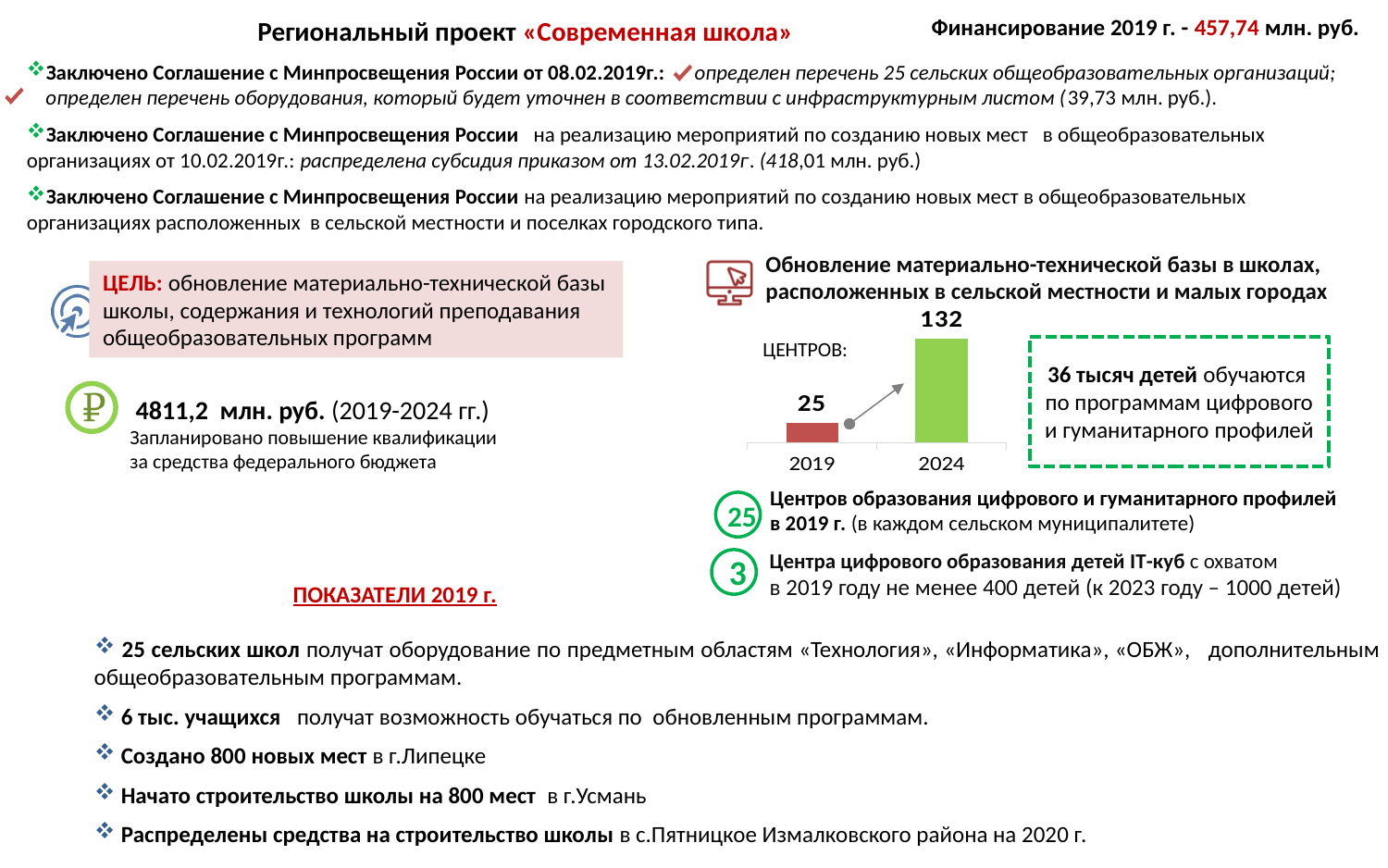
Which year has the lowest value in the chart? 2019 Which year has the higher value in the chart, 2019 or 2024? 2024 How many years (categories) are shown in the chart? 2 Which year has the highest value in the chart? 2024 What value does the chart show for 2019? 25 What type of chart is shown on the slide? bar chart What label appears next to the bars in the chart indicating what is being counted? ЦЕНТРОВ: What value does the chart show for 2024? 132 Do the values in the chart rise or fall from 2019 to 2024? rise What is the difference between the values for 2024 and 2019 in the chart? 107 What colour is the bar for 2024 in the chart? green